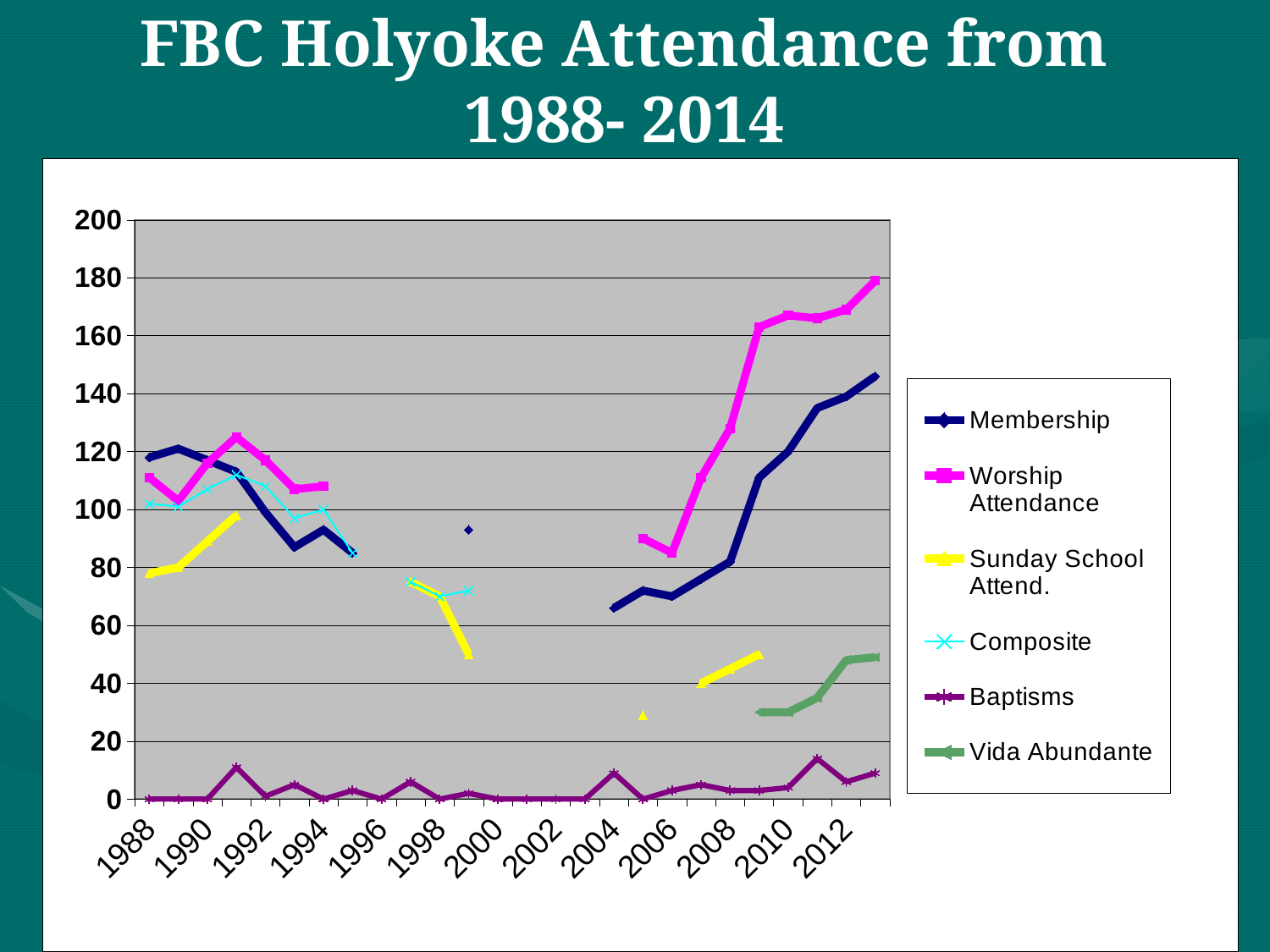
Does Worship Attendance rise or fall between 2006 and the last plotted year? rise What kind of chart is shown on the slide? line chart Is the highest value of Worship Attendance greater or less than 160? greater In 2012, which is larger, Worship Attendance or Membership? Worship Attendance How many series does the legend list? 6 Which series reaches the highest value anywhere on the chart? Worship Attendance Is the value for Sunday School Attend. in 1988 greater or less than 100? less Is the value for Membership in 1988 greater or less than 100? greater In 2012, which is larger, Vida Abundante or Baptisms? Vida Abundante What is the title of the slide's chart? FBC Holyoke Attendance from 1988- 2014 Which series is drawn in yellow? Sunday School Attend.